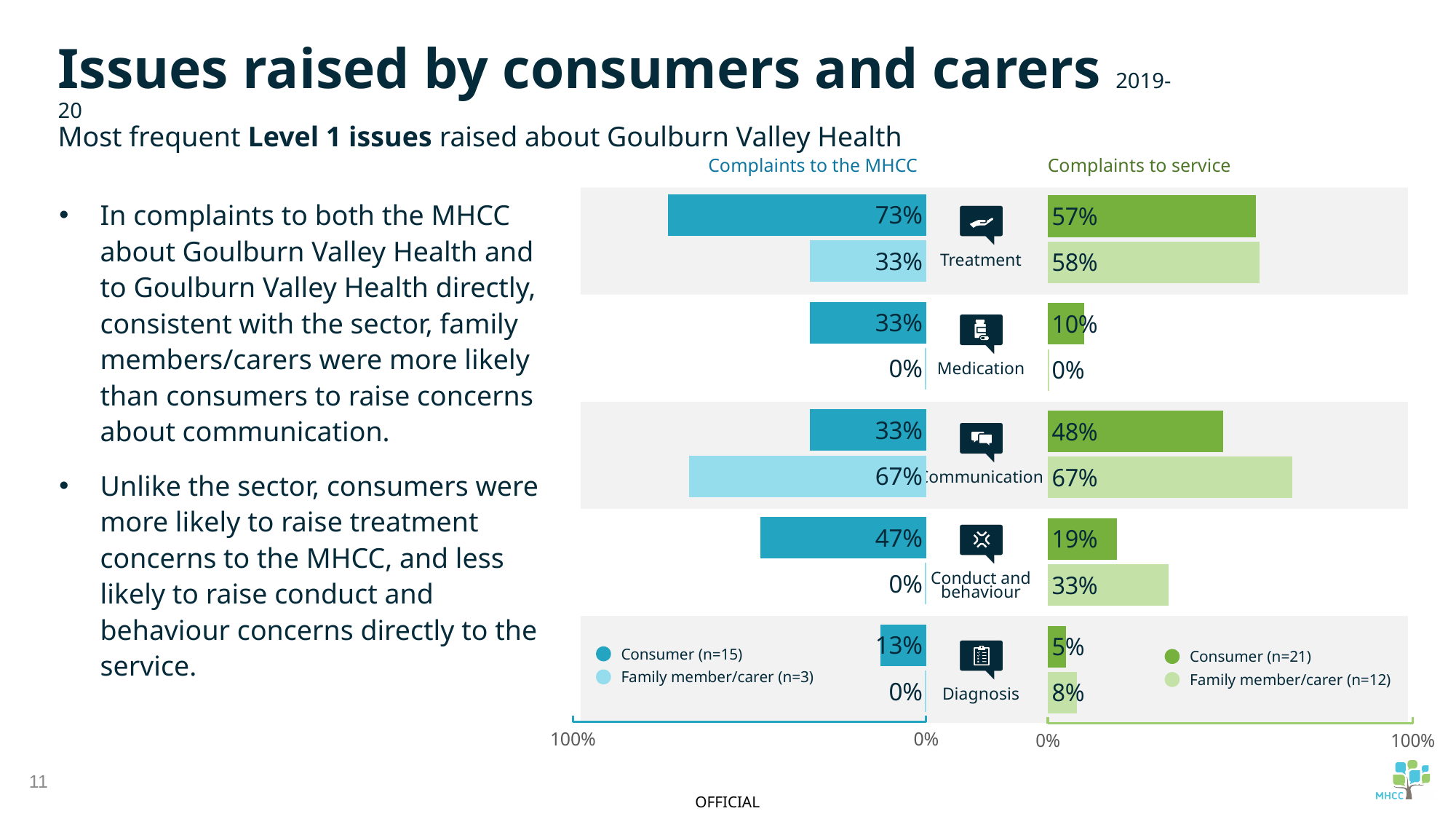
In the 'Complaints to service' chart, which issue has the lowest consumer percentage? Diagnosis According to the legend of the 'Complaints to the MHCC' chart, how many family member/carer complaints were there? n=3 In the 'Complaints to the MHCC' chart, which is larger for Communication: the consumer percentage or the family member/carer percentage? Family member/carer In the 'Complaints to service' chart, what percentage of family member/carer complaints raised Communication? 67% In the 'Complaints to the MHCC' chart, what percentage of consumer complaints raised Treatment? 73% In the 'Complaints to the MHCC' chart, what is the difference between the consumer and family member/carer percentages for Treatment? 40 percentage points How many issue categories are shown in the 'Complaints to the MHCC' chart? 5 How many series does the legend of the 'Complaints to service' chart list? 2 In the 'Complaints to the MHCC' chart, which issue has the highest consumer percentage? Treatment In the 'Complaints to service' chart, what is the difference between the family member/carer and consumer percentages for Communication? 19 percentage points What type of chart is the 'Complaints to service' chart? Bar chart In the 'Complaints to service' chart, what percentage of consumer complaints raised Conduct and behaviour? 19%